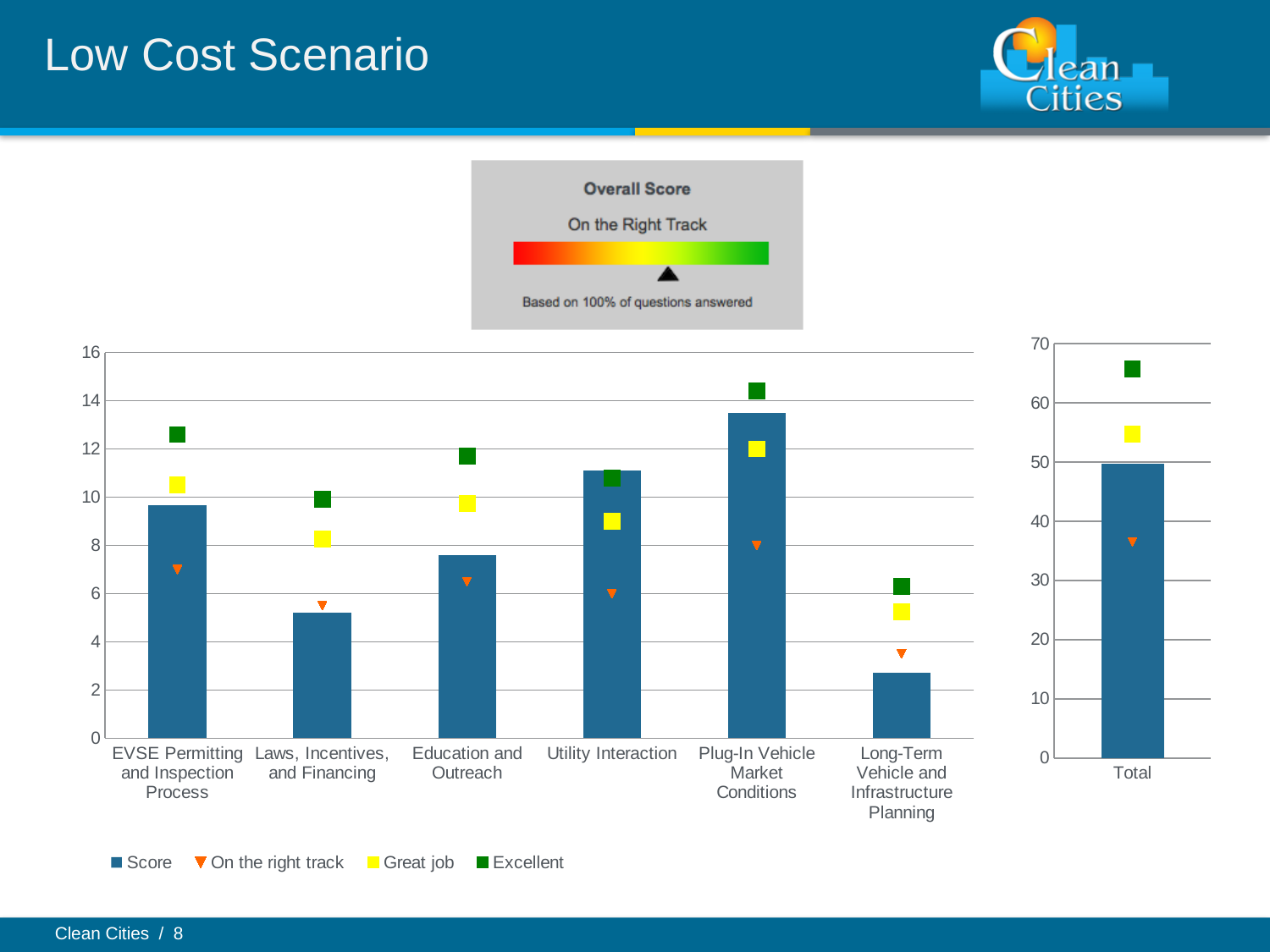
In the left chart, which has the higher Score bar: Plug-In Vehicle Market Conditions or EVSE Permitting and Inspection Process? Plug-In Vehicle Market Conditions In the right chart, is the Total Score bar greater or less than 40? greater In the left chart, is the Score for EVSE Permitting and Inspection Process greater or less than 8? greater In the left chart, which category has the lowest Score bar? Long-Term Vehicle and Infrastructure Planning What kind of chart is the left chart showing scores by category? bar chart How many series does the legend list? 4 In the left chart, which has the higher Score bar: Utility Interaction or Education and Outreach? Utility Interaction What colour is the legend marker for the "Excellent" series? green In the left chart, is the Score for Laws, Incentives, and Financing greater or less than 6? less How many categories are shown on the x axis of the left chart? 6 In the left chart, which category has the highest Score bar? Plug-In Vehicle Market Conditions